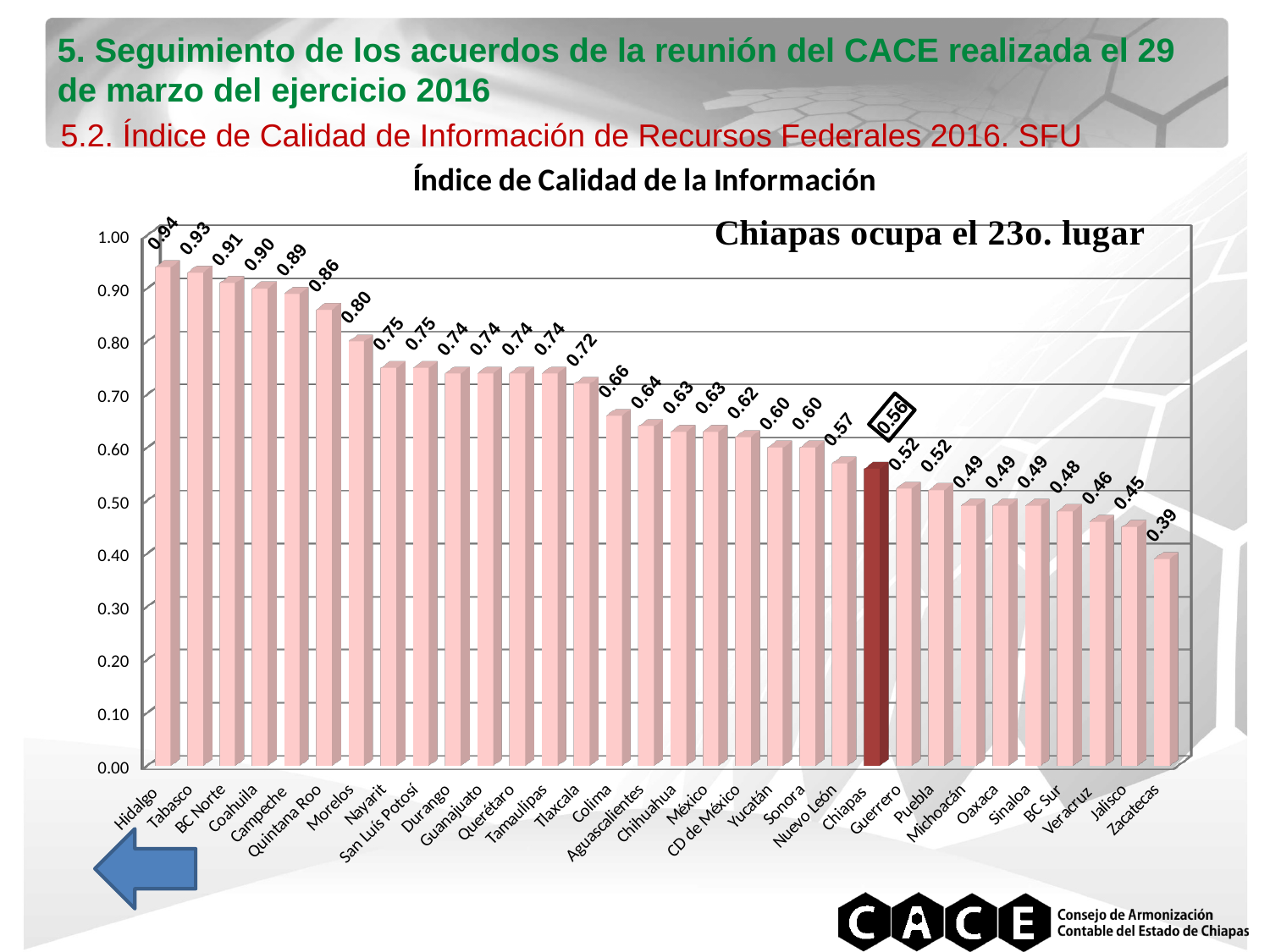
What is the value for Hidalgo? 0.94 What is the value for Chiapas in the Índice de Calidad de la Información chart? 0.56 Which state has the highest value in the chart? Hidalgo Which has a larger value, Colima or Guerrero? Colima How many states are shown in the chart? 32 Which state has the lowest value in the chart? Zacatecas What is the value for Zacatecas? 0.39 What is the difference between the values for Hidalgo and Chiapas? 0.38 According to the annotation on the chart, what position does Chiapas occupy? 23o. lugar Is the value for Nuevo León greater or less than 0.60? less What is the value for Morelos? 0.80 What kind of chart is shown on the slide? Bar chart